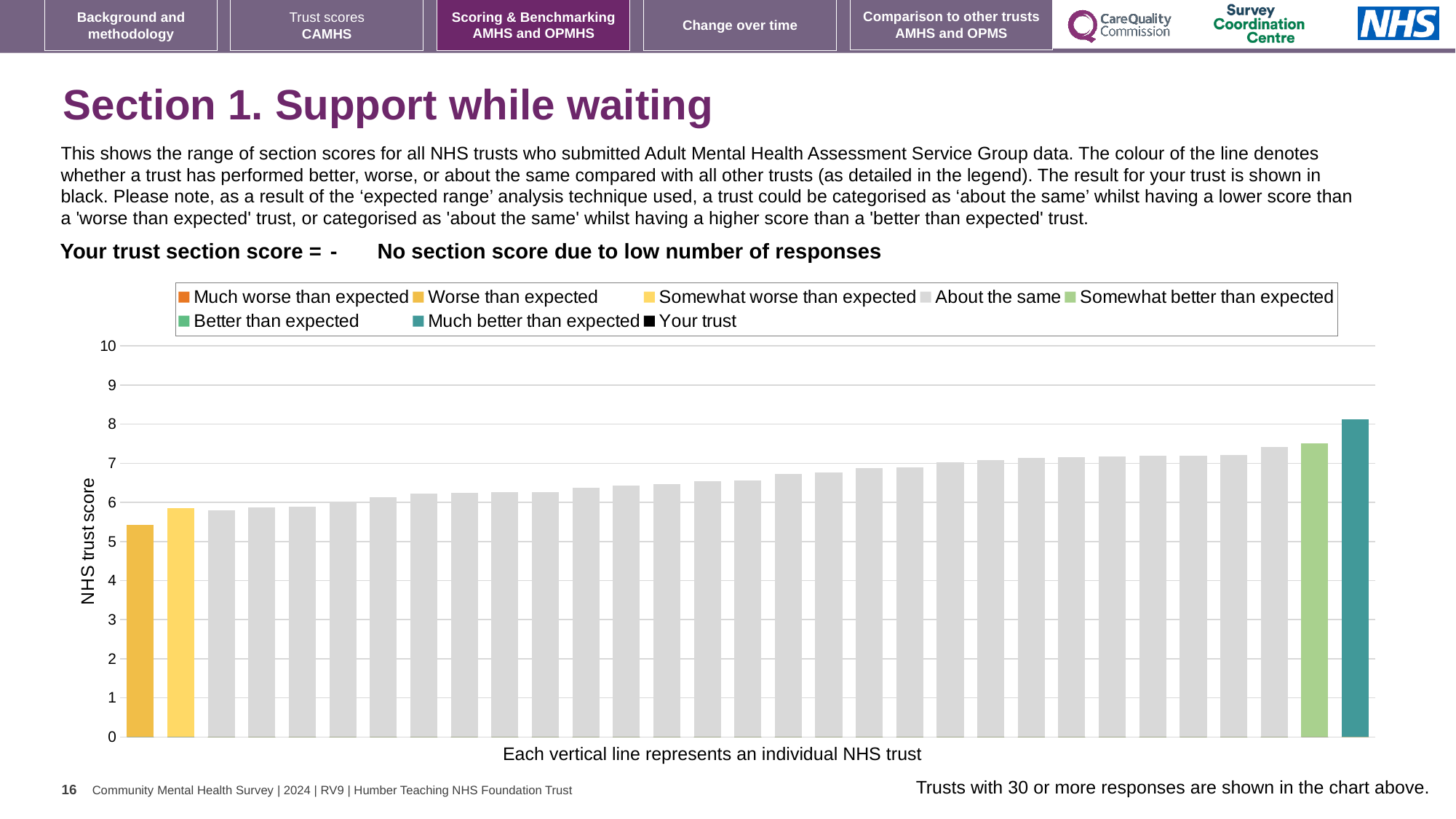
Which bar is the tallest in the chart, the leftmost or the rightmost? rightmost How many entries does the chart legend list? 8 Which legend category does the shortest bar belong to? Worse than expected What is the label on the x axis of the chart? Each vertical line represents an individual NHS trust Is the value of the rightmost bar greater or less than 8? greater Do the bar values rise or fall from left to right along the x axis? rise What is the label on the y axis of the chart? NHS trust score What kind of chart is shown on the slide? bar chart Is the value of the second bar from the left greater or less than 6? less Is the value of the leftmost bar greater or less than 6? less Which legend category does the tallest bar belong to? Much better than expected How many bars (NHS trusts) are plotted in the chart? 31